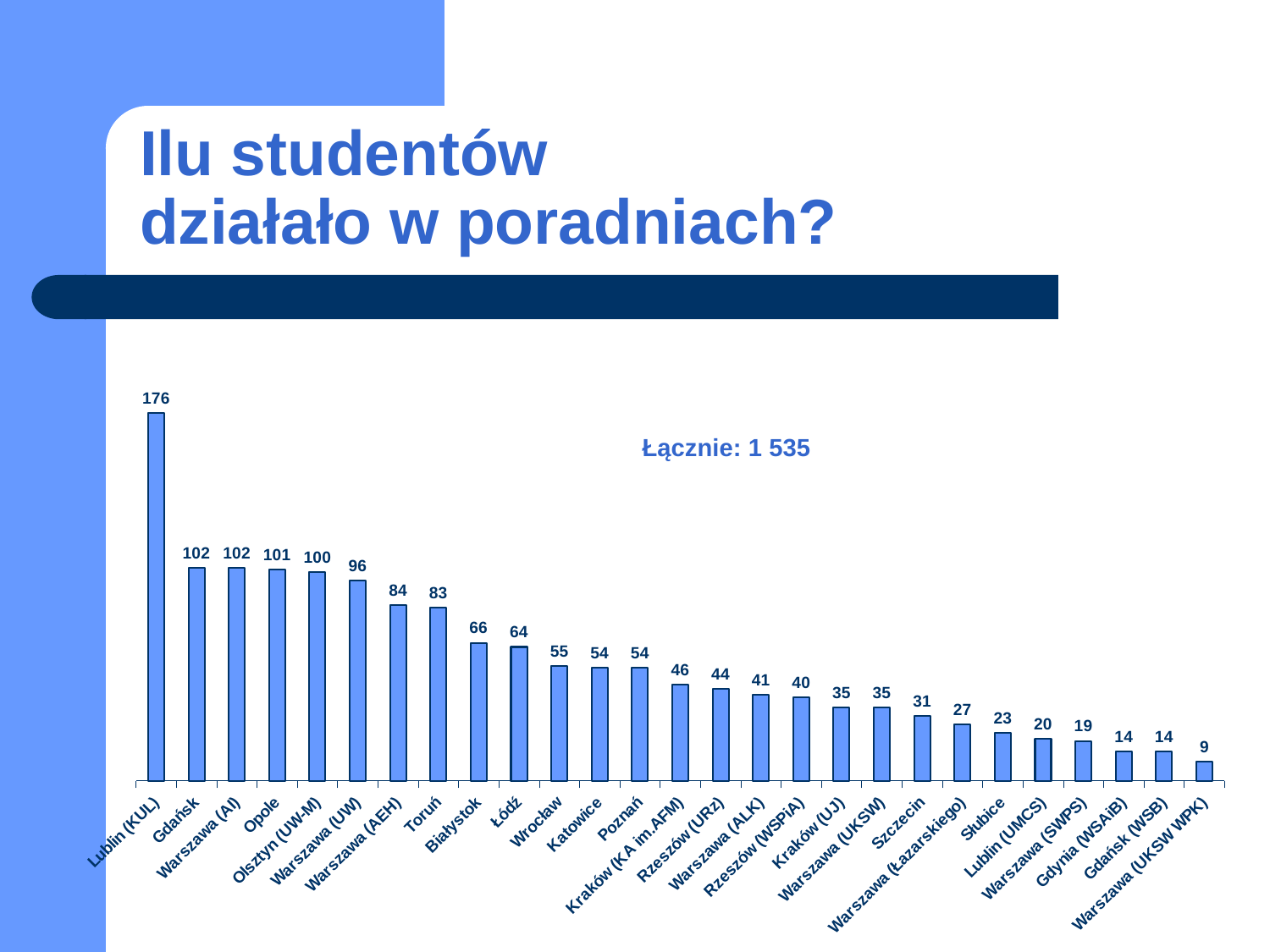
What is the value shown for Toruń? 83 How many categories are shown on the x axis? 27 What is the difference between the values for Lublin (KUL) and Gdańsk? 74 What is the difference between the values for Białystok and Łódź? 2 Do the values rise or fall from left to right along the x axis? Fall What kind of chart is shown on the slide? Bar chart Which category has the lowest value? Warszawa (UKSW WPK) Which category has the highest value? Lublin (KUL) How many students were active at Lublin (KUL)? 176 What is the value shown for Szczecin? 31 Which is larger, the value for Warszawa (UW) or the value for Warszawa (AEH)? Warszawa (UW) What total is printed on the chart (Łącznie)? 1 535